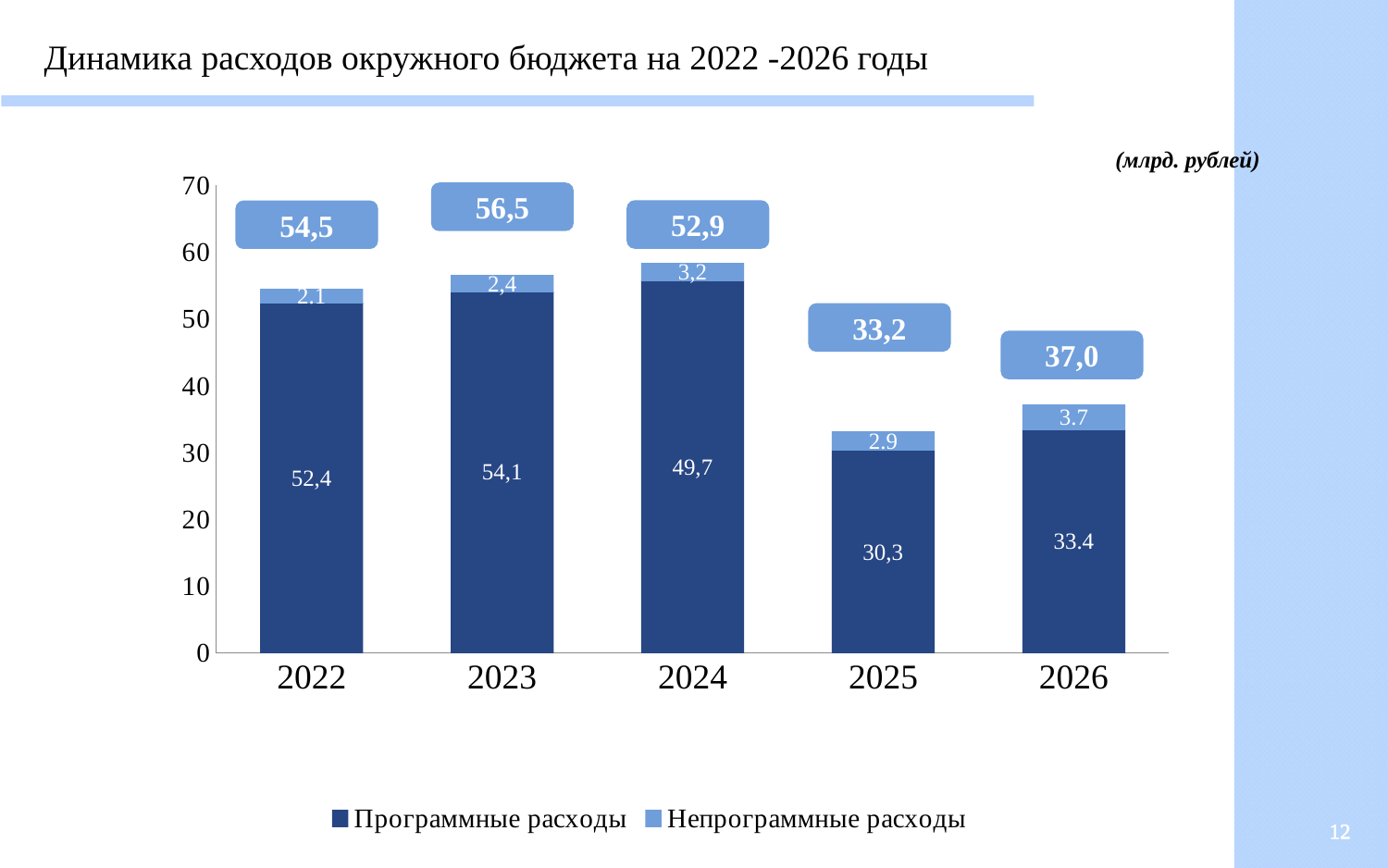
Which year has the lowest total expenditure? 2025 Which is larger: Непрограммные расходы in 2022 or in 2026? 2026 What is the value of Программные расходы for 2023? 54,1 Which year has the highest total expenditure? 2023 What is the value of Программные расходы for 2025? 30,3 What unit is indicated for the values on the chart? млрд. рублей How many years are shown on the x axis? 5 What type of chart is shown on the slide? bar chart What is the total shown above the bar for 2026? 37,0 What is the value of Непрограммные расходы for 2024? 3,2 How many series does the legend list? 2 What is the difference between Программные расходы in 2023 and 2024? 4,4